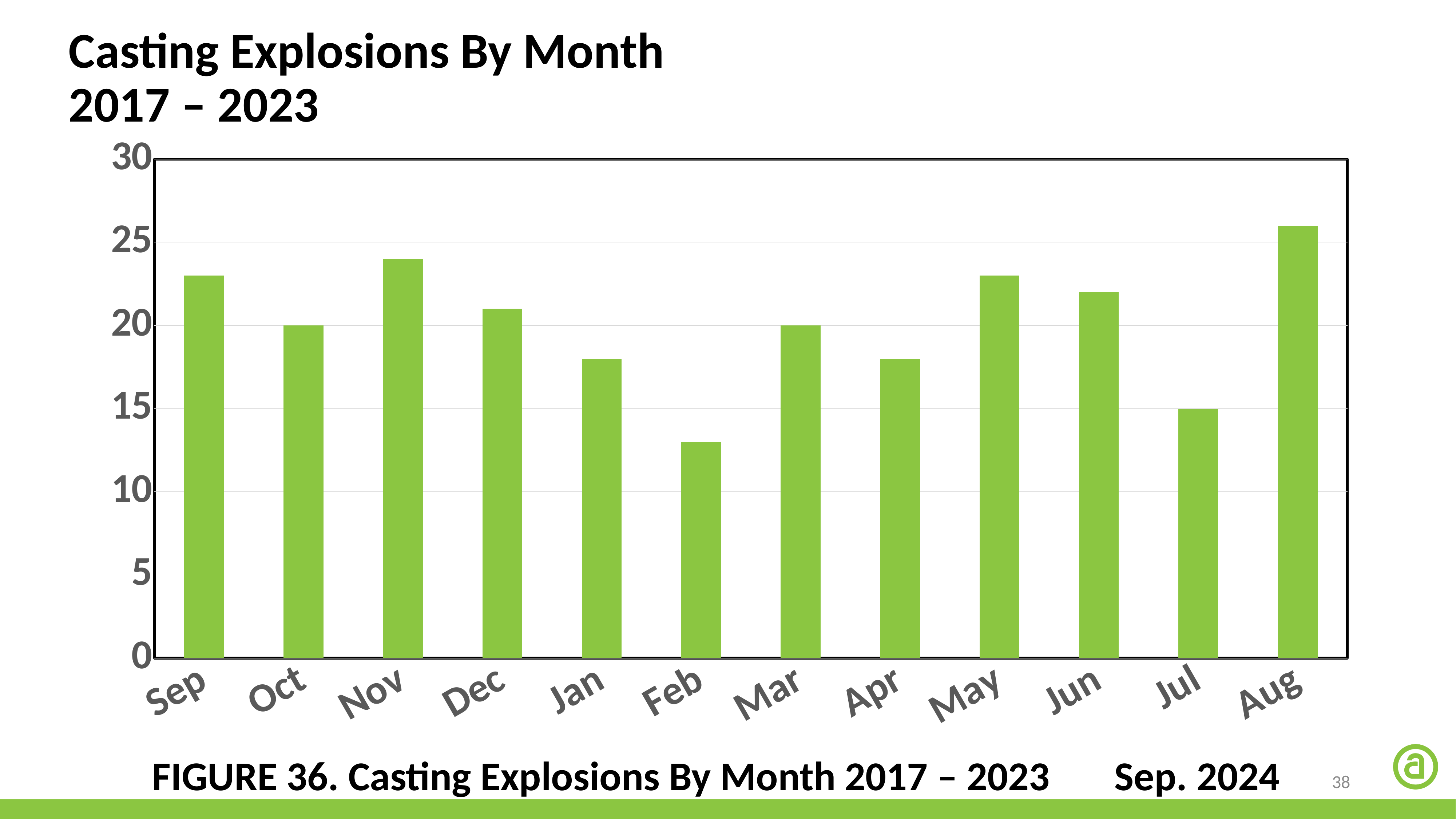
Which month has the highest number of casting explosions? Aug Is the value for Sep greater or less than 20? greater What is the value for Jul? 15 Which month has more casting explosions, Nov or Dec? Nov Is the value for Jan greater or less than 20? less What is the title of the chart? Casting Explosions By Month 2017 – 2023 Is the value for Aug greater or less than 25? greater What type of chart is shown on the slide? bar chart What is the value for Oct? 20 Which month has the lowest number of casting explosions? Feb How many months are shown on the x axis of the chart? 12